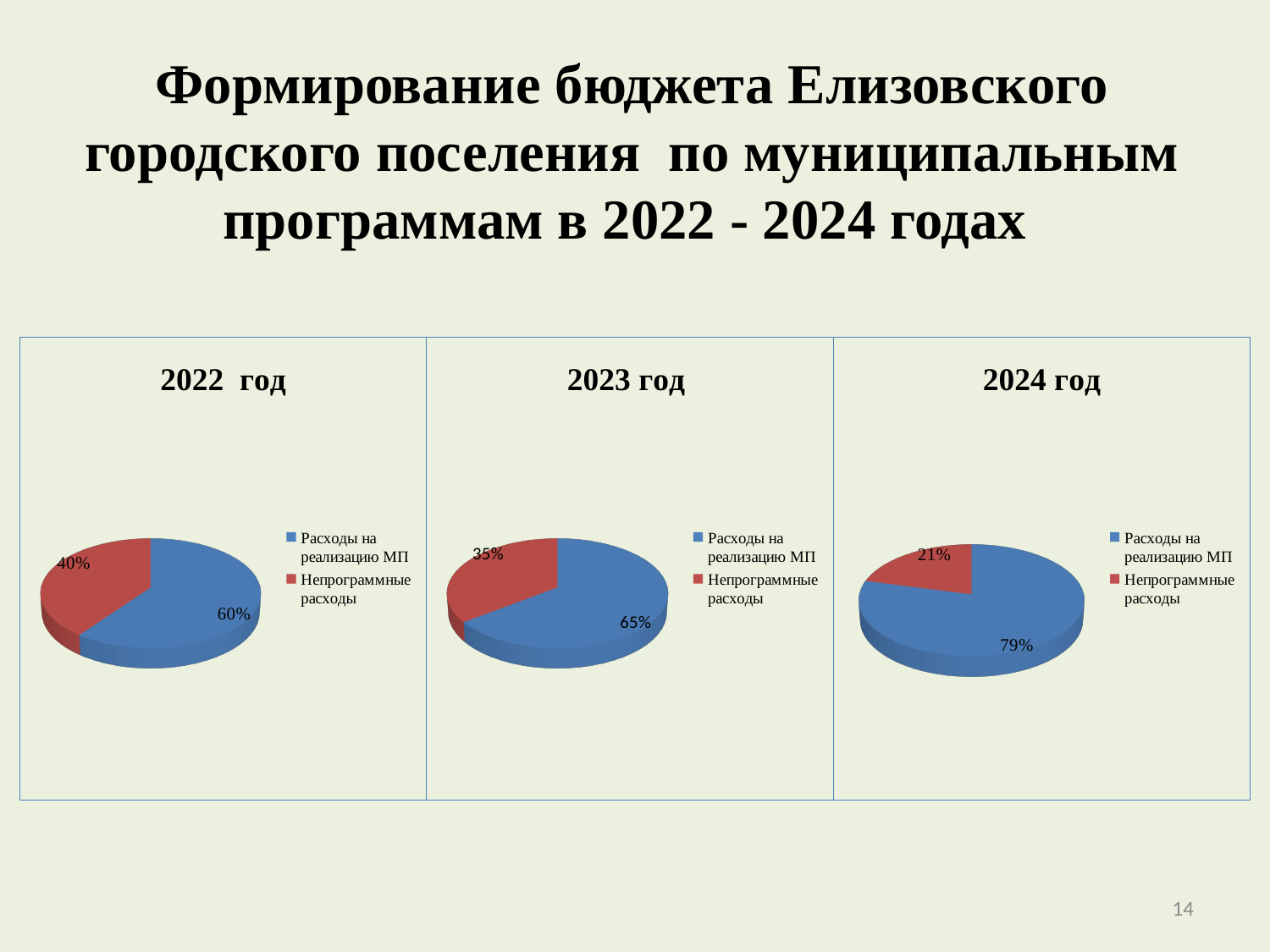
In the 2023 год chart, what is the difference between the Расходы на реализацию МП share and the Непрограммные расходы share? 30% In the 2023 год chart, what share of the pie is Расходы на реализацию МП? 65% In the 2024 год chart, which slice is the largest? Расходы на реализацию МП How many slices does the 2023 год chart have? 2 In the 2022 год chart, what share of the pie is Непрограммные расходы? 40% In the 2023 год chart, what share of the pie is Непрограммные расходы? 35% In the 2024 год chart, what colour is the Непрограммные расходы slice? Red What kind of chart is the 2022 год chart? Pie chart In the 2022 год chart, which slice is the smallest? Непрограммные расходы